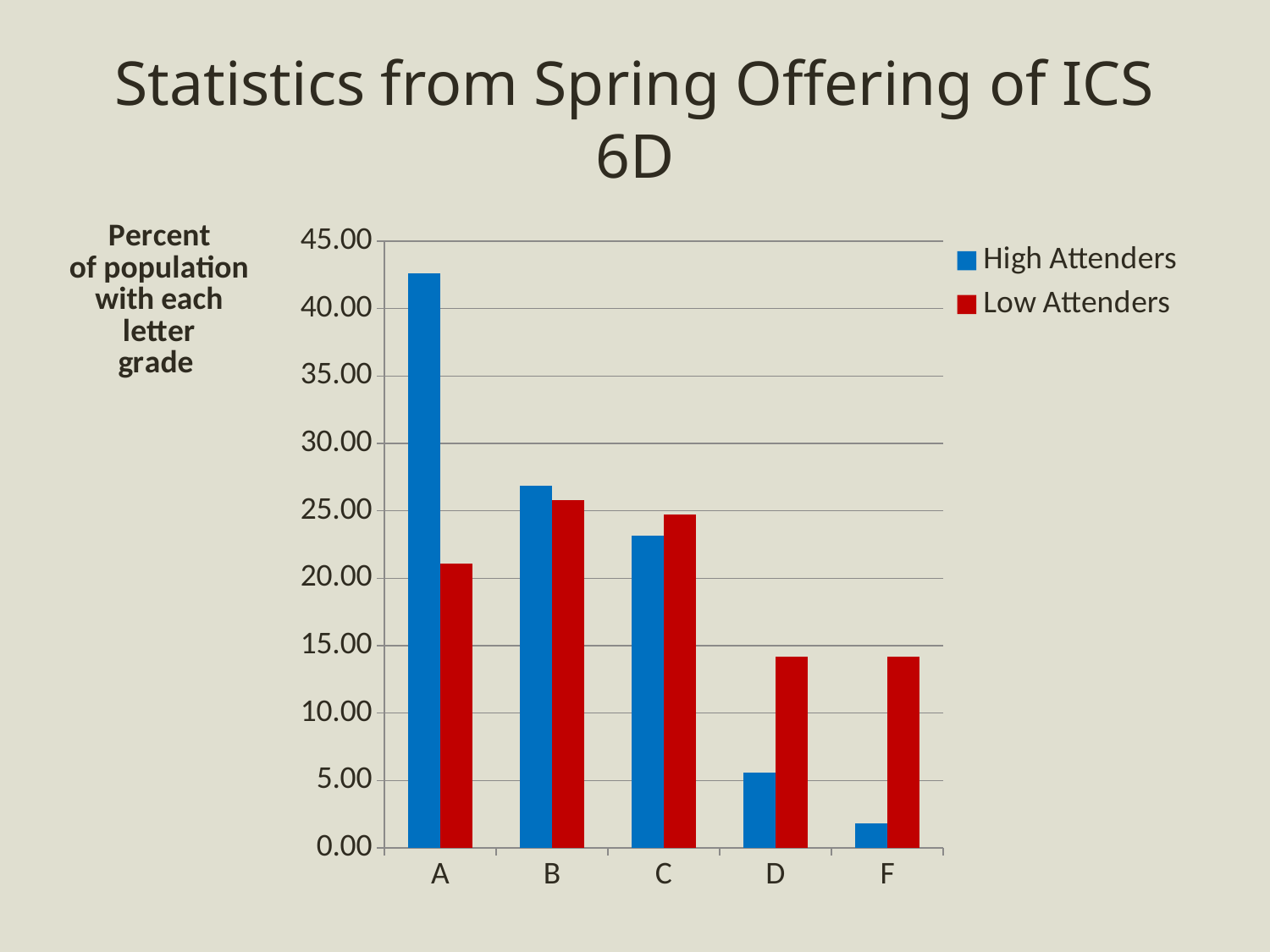
Which letter grade has the highest value for High Attenders? A Is the High Attenders value for grade D greater or less than 10.00? less For grade D, which series has the larger value, High Attenders or Low Attenders? Low Attenders For grade A, which series has the larger value, High Attenders or Low Attenders? High Attenders How many letter grade categories are shown on the x axis? 5 Which letter grade has the lowest value for High Attenders? F What kind of chart is shown on the slide? bar chart Is the Low Attenders value for grade A greater or less than 25.00? less Is the Low Attenders value for grade F greater or less than 10.00? greater Do the High Attenders values rise or fall from grade A to grade F? fall How many series does the legend list? 2